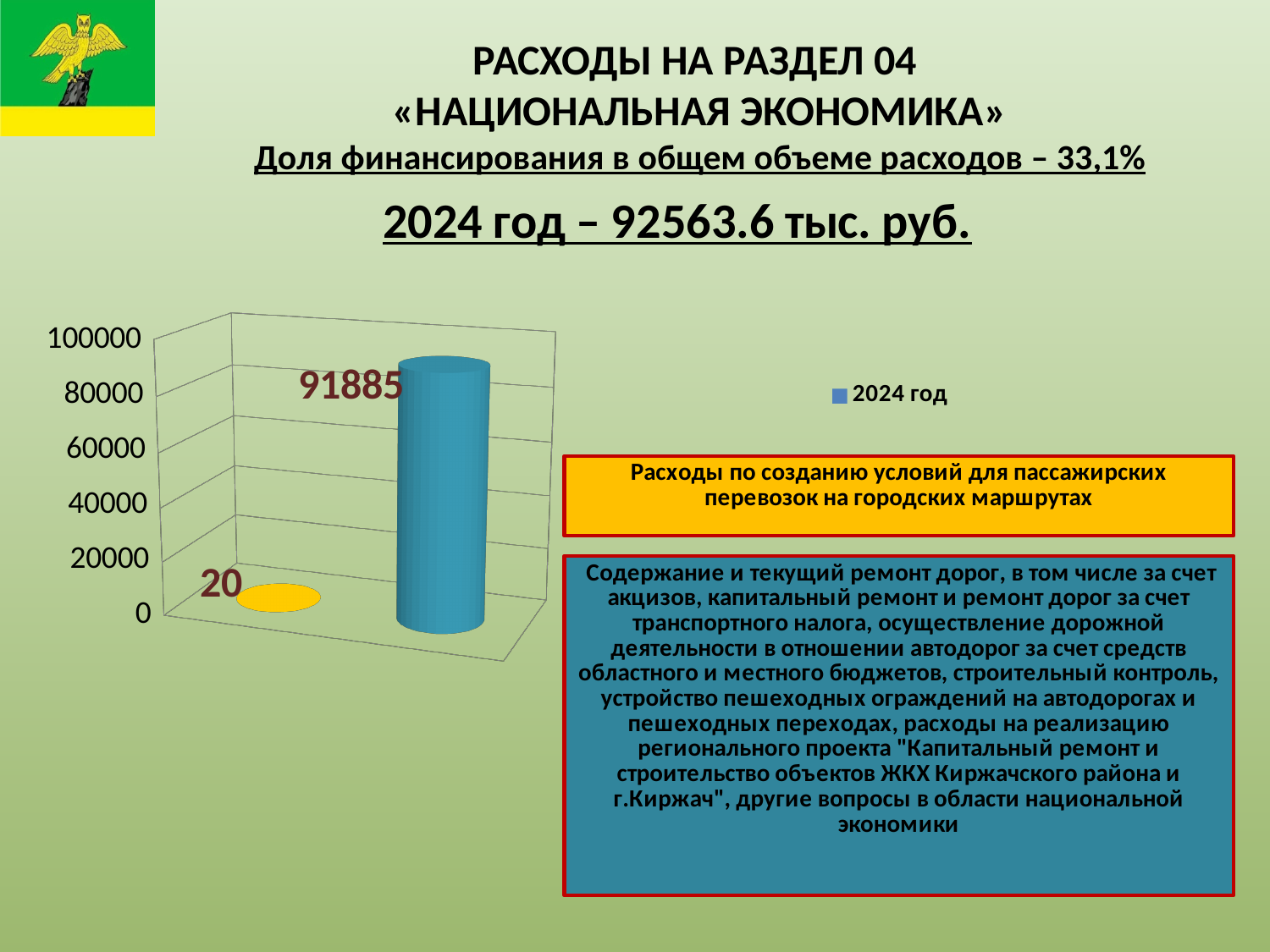
What value is printed on the blue bar in the chart? 91885 Which bar in the chart is the highest, the blue one or the yellow one? the blue one Which bar in the chart is the lowest, the blue one or the yellow one? the yellow one What value is printed on the yellow bar in the chart? 20 What is the difference between the values of the blue bar and the yellow bar in the chart? 91865 What is the legend entry of the chart? 2024 год What kind of chart is shown on the slide? bar chart Is the value of the yellow bar greater or less than 20000? less How many series does the chart legend list? 1 Is the value of the blue bar greater or less than 80000? greater What is the highest value shown on the vertical axis of the chart? 100000 How many bars are plotted in the chart? 2